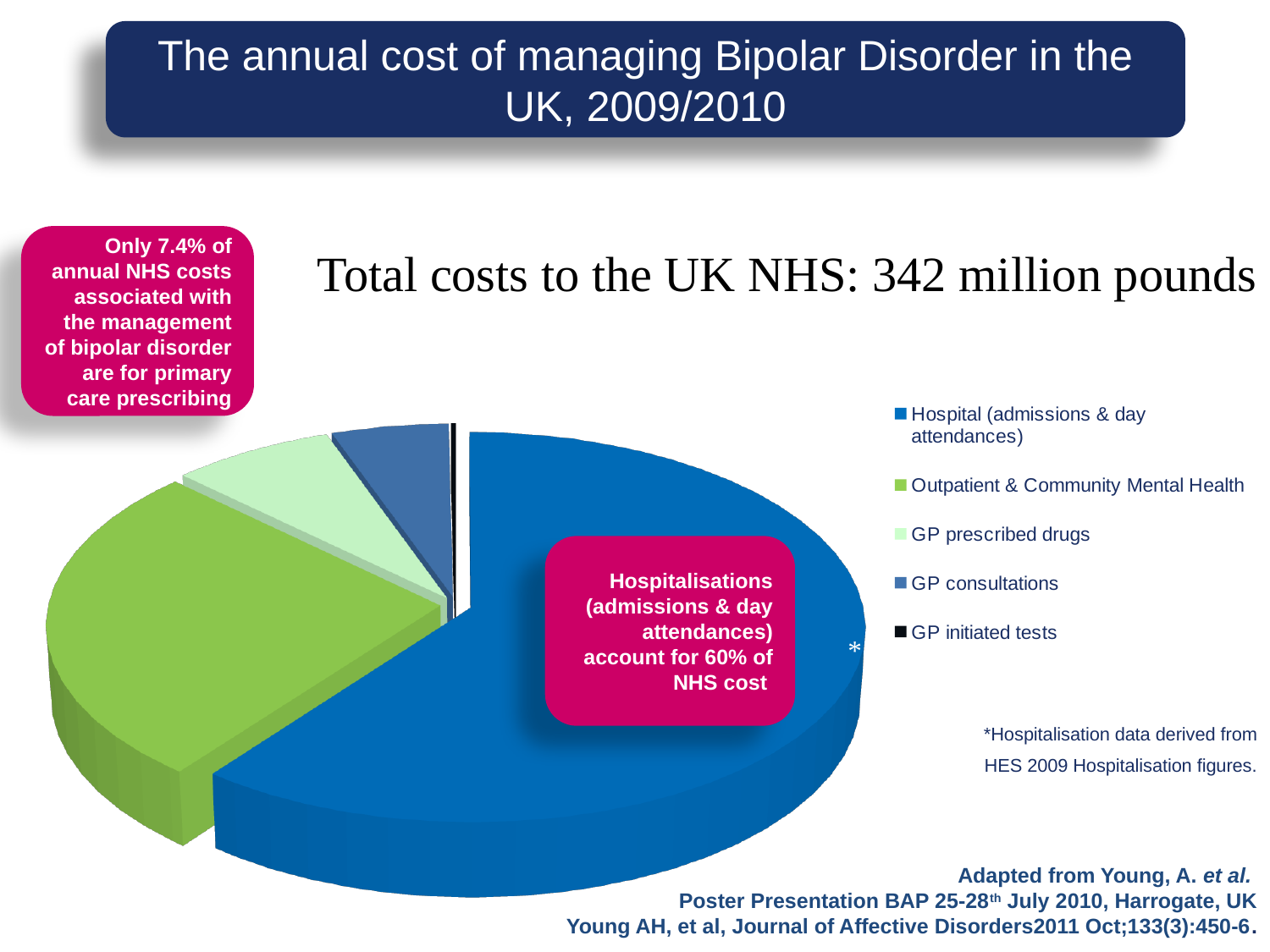
Which is larger: the share for GP prescribed drugs or the share for GP consultations? GP prescribed drugs How many categories does the pie chart show? 5 According to the slide, what share of NHS cost do hospitalisations (admissions & day attendances) account for? 60% What is the total cost to the UK NHS stated on the slide? 342 million pounds What colour is the slice for Hospital (admissions & day attendances)? Blue Which category accounts for the smallest share of the pie? GP initiated tests Which is larger: the share for Hospital (admissions & day attendances) or the share for Outpatient & Community Mental Health? Hospital (admissions & day attendances) What kind of chart is shown on the slide? Pie chart How many entries does the legend list? 5 Which category accounts for the largest share of the pie? Hospital (admissions & day attendances) Which is larger: the share for Outpatient & Community Mental Health or the share for GP prescribed drugs? Outpatient & Community Mental Health